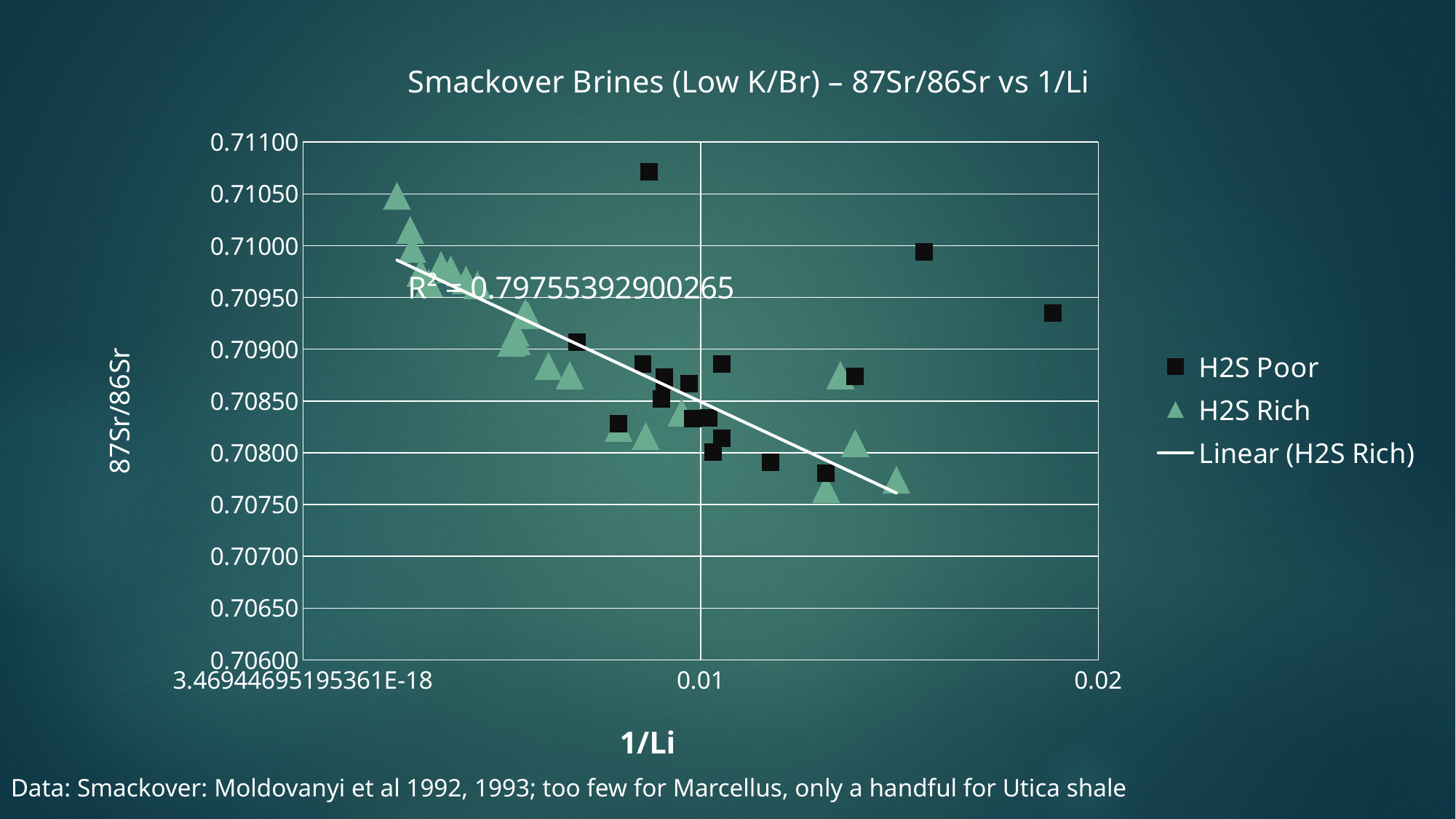
What are the entries listed in the chart legend? H2S Poor, H2S Rich, Linear (H2S Rich) How many entries does the chart legend list? 3 Does the linear trendline for H2S Rich slope upward or downward from left to right? Downward Is the 87Sr/86Sr value of the highest H2S Poor point greater or less than 0.71050? greater Is the 87Sr/86Sr value of the rightmost H2S Rich point greater or less than 0.70750? greater What kind of chart is shown on the slide? Scatter chart Is the 87Sr/86Sr value of the rightmost H2S Poor point (near 1/Li = 0.02) greater or less than 0.70950? less What is the title of the chart? Smackover Brines (Low K/Br) – 87Sr/86Sr vs 1/Li Do the 87Sr/86Sr values of the H2S Rich points rise or fall as 1/Li increases along the x axis? Fall What R² value is printed on the chart for the linear trendline? R² = 0.79755392900265 What is the maximum value shown on the y axis of the chart? 0.71100 Which series contains the point with the highest 87Sr/86Sr value on the chart? H2S Poor